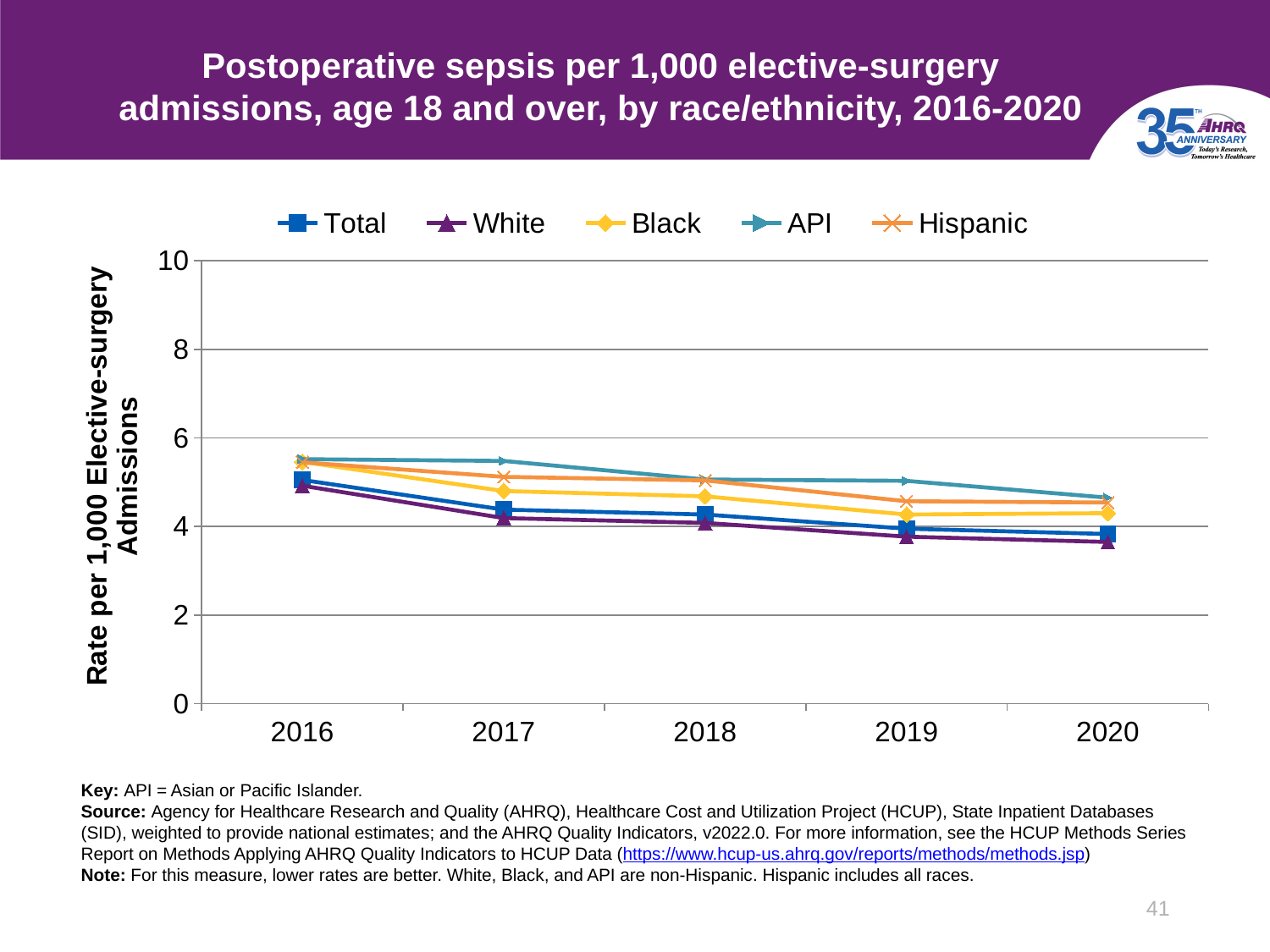
Is the value for API in 2016 greater or less than 6? less Does the rate for API rise or fall from 2016 to 2020? fall Is the value for Total in 2016 greater or less than 4? greater What kind of chart is shown on the slide? line chart What does API stand for according to the key on the slide? Asian or Pacific Islander Which race/ethnicity group has the lowest rate in 2020? White Which is larger in 2019, the rate for API or the rate for Total? API Is the value for White in 2020 greater or less than 4? less Which is larger in 2018, the rate for Black or the rate for White? Black How many years are shown on the x axis? 5 How many series does the legend list? 5